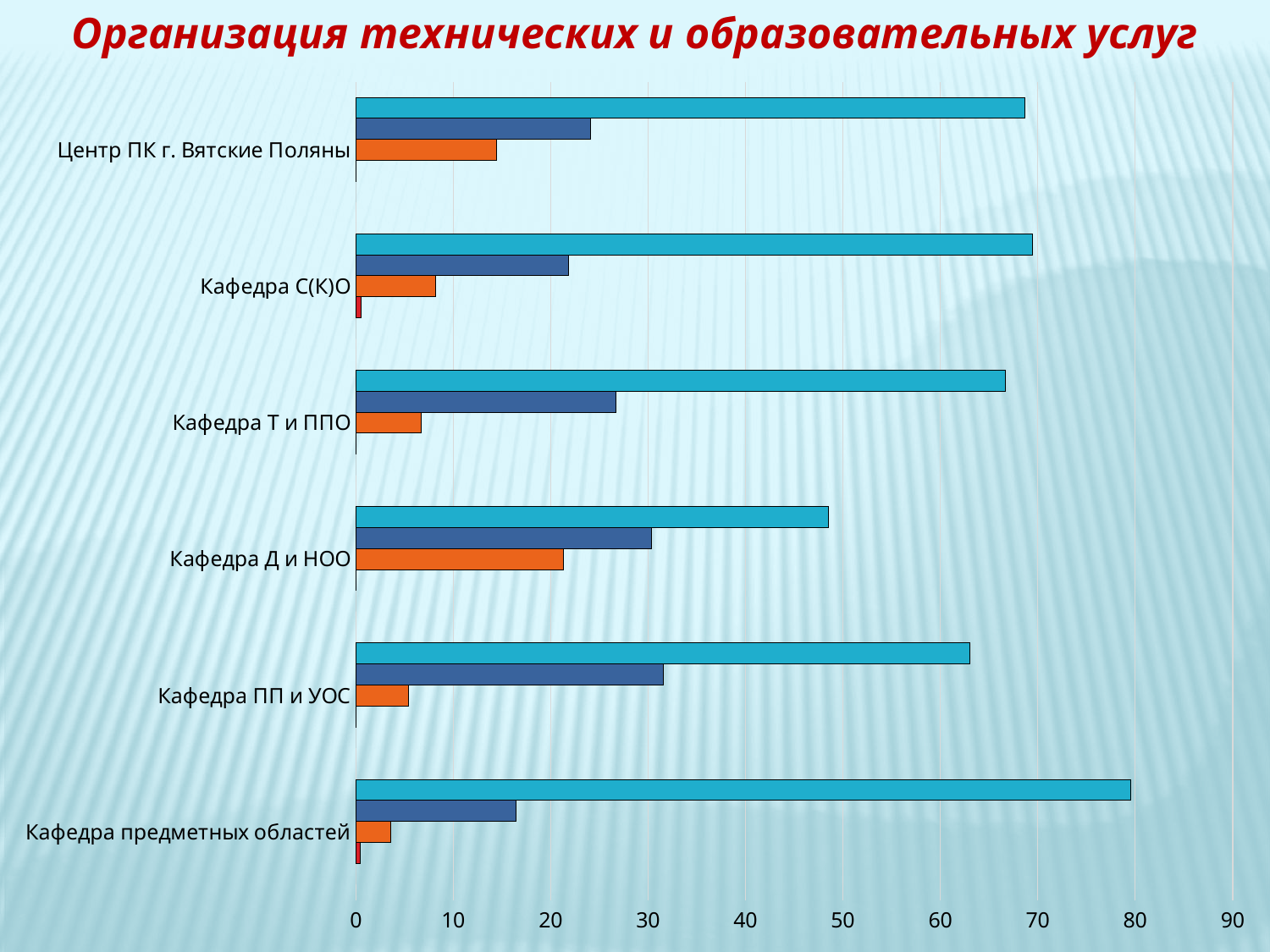
Which category has the longest light blue bar? Кафедра предметных областей Which category has the longest orange bar? Кафедра Д и НОО Is the light blue bar for Кафедра Д и НОО greater or less than 50? less Which has the longer orange bar: Центр ПК г. Вятские Поляны or Кафедра С(К)О? Центр ПК г. Вятские Поляны Which category has the shortest light blue bar? Кафедра Д и НОО What is the title of the slide? Организация технических и образовательных услуг Is the light blue bar for Кафедра предметных областей greater or less than 70? greater Is the orange bar for Кафедра ПП и УОС greater or less than 10? less Which has the longer light blue bar: Кафедра Д и НОО or Кафедра ПП и УОС? Кафедра ПП и УОС What kind of chart is shown on the slide? bar chart How many categories are listed on the vertical axis of the chart? 6